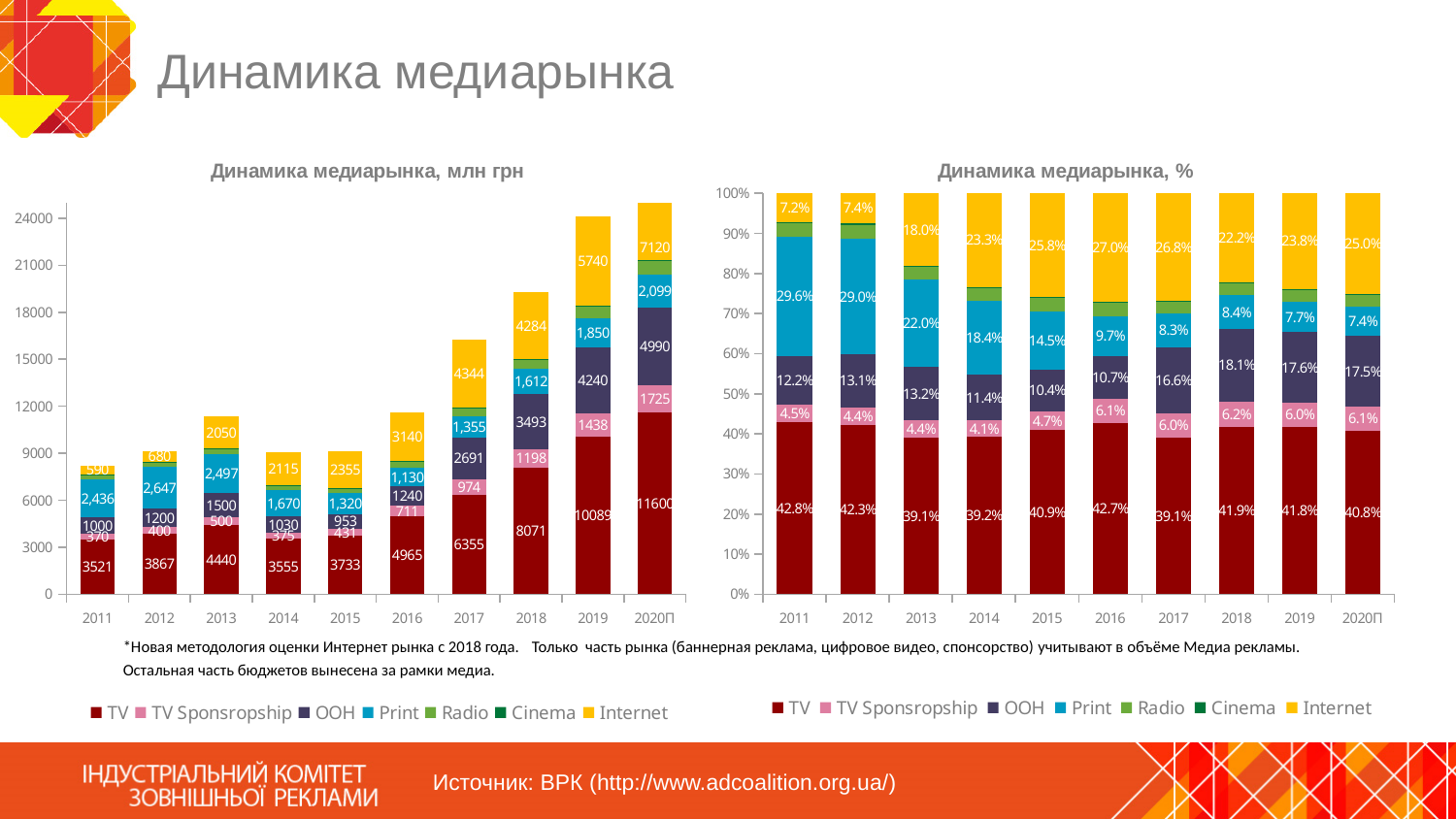
In the chart 'Динамика медиарынка, млн грн', which year has the highest TV value? 2020П In the chart 'Динамика медиарынка, млн грн', what is the Internet value for 2020П? 7120 How many series does the legend of the chart 'Динамика медиарынка, млн грн' list? 7 In the chart 'Динамика медиарынка, млн грн', which is larger: the OOH value for 2017 or the Internet value for 2017? Internet (4344) In the chart 'Динамика медиарынка, млн грн', what is the difference between the TV values for 2018 and 2017? 1716 In the chart 'Динамика медиарынка, %', which year has the lowest Print share? 2020П In the chart 'Динамика медиарынка, %', does the Print share rise or fall from 2011 to 2020П? fall In the chart 'Динамика медиарынка, млн грн', what is the TV value for 2019? 10089 In the chart 'Динамика медиарынка, млн грн', what is the Print value for 2012? 2,647 In the chart 'Динамика медиарынка, %', what is the Internet share for 2016? 27.0% What kind of chart is 'Динамика медиарынка, %'? stacked bar chart In the chart 'Динамика медиарынка, %', what is the Print share for 2011? 29.6%